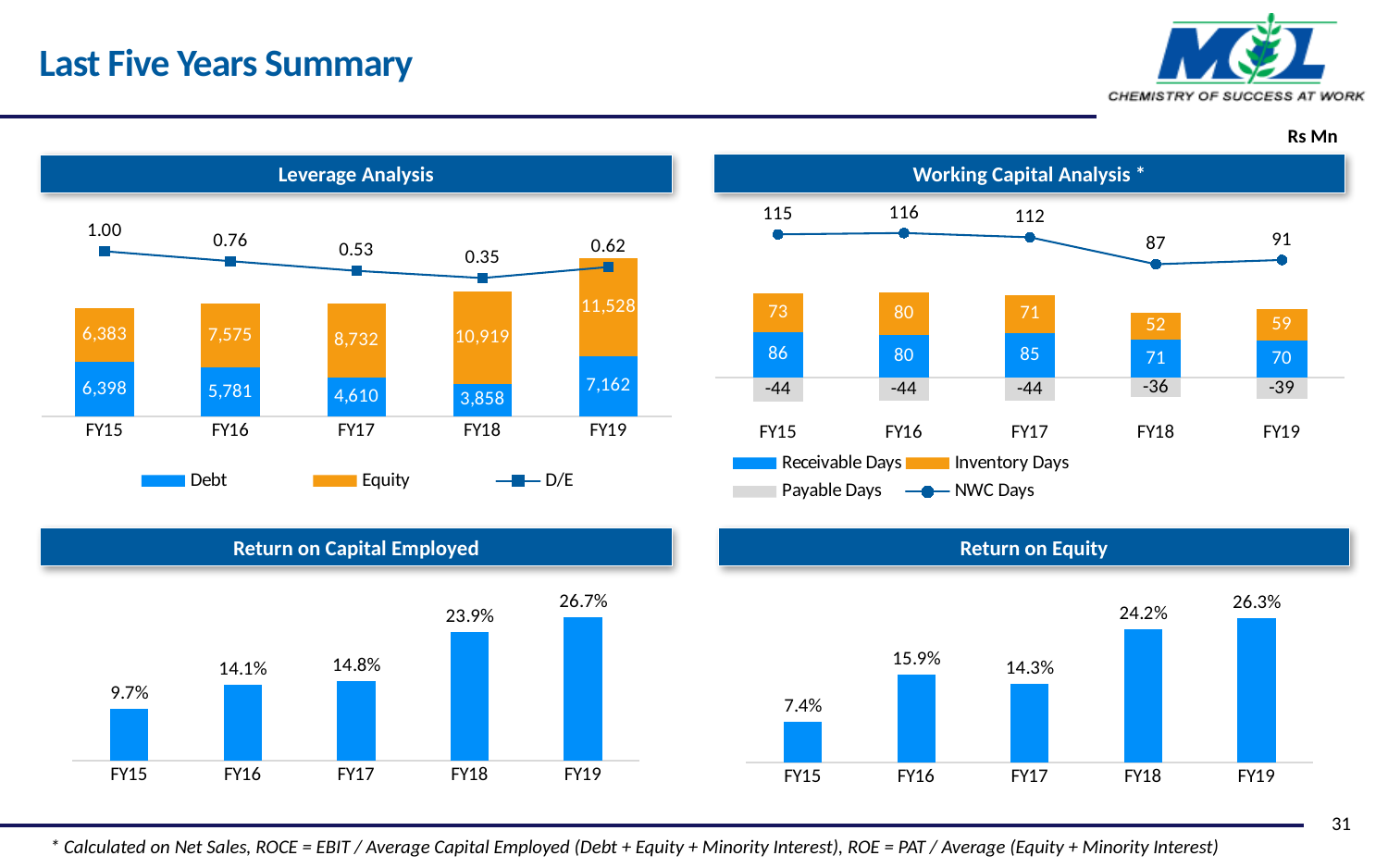
In the Working Capital Analysis chart, what is the NWC Days value for FY17? 112 How many series does the legend of the Leverage Analysis chart list? 3 In the Return on Capital Employed chart, by how many percentage points does FY19 exceed FY15? 17.0 percentage points In the Return on Capital Employed chart, what is the value for FY18? 23.9% In the Working Capital Analysis chart, which year has the highest Inventory Days? FY16 In the Leverage Analysis chart, which year has the lowest D/E ratio? FY18 What kind of chart is the Return on Equity chart? Bar chart In the Leverage Analysis chart, what is the Debt value for FY19? 7,162 In the Working Capital Analysis chart, what is the Payable Days value for FY18? -36 In the Leverage Analysis chart, what is the difference between Equity and Debt in FY18? 7,061 In the Return on Equity chart, which is larger, FY16 or FY17? FY16 How many series does the legend of the Working Capital Analysis chart list? 4